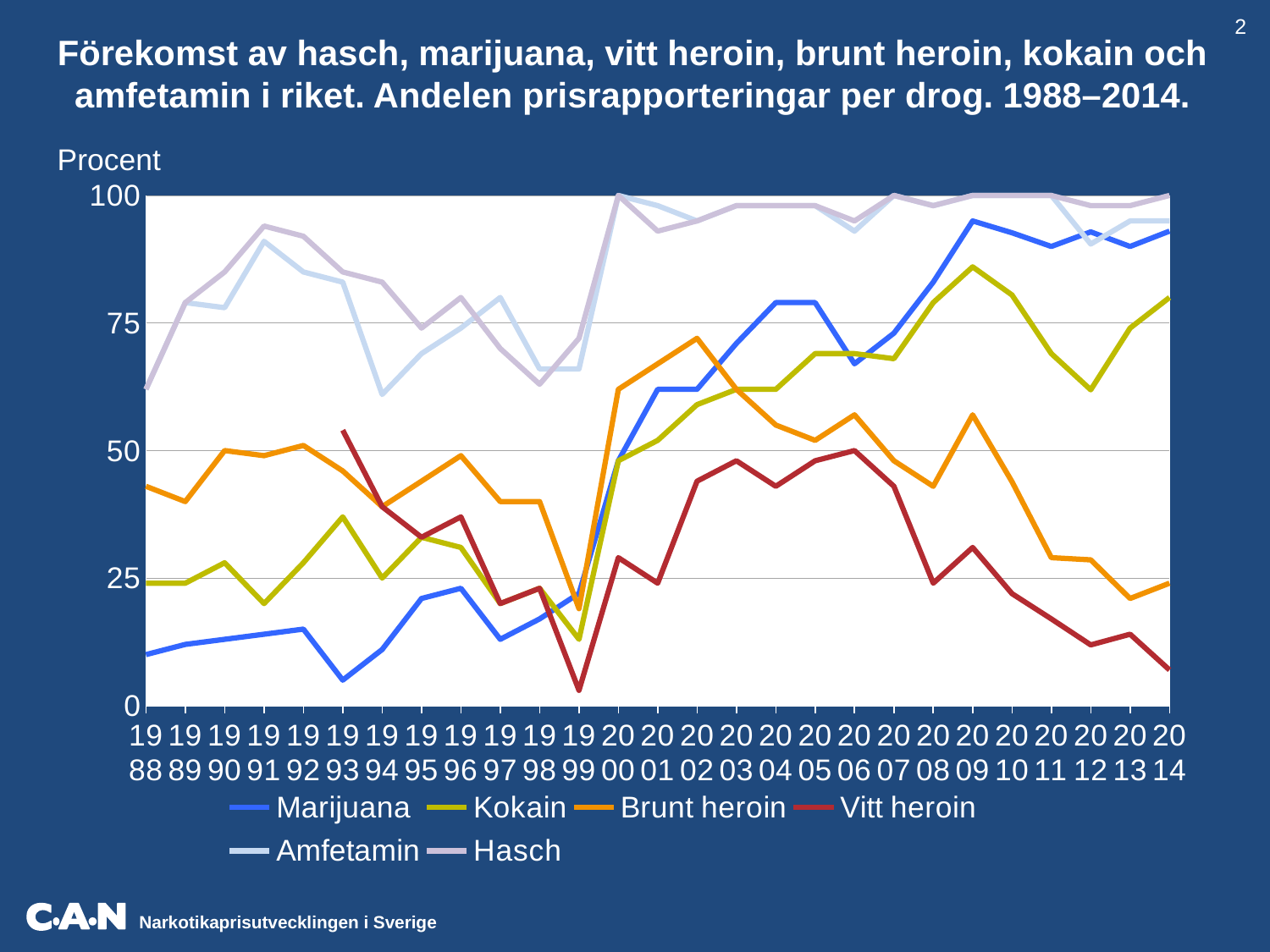
How many series does the legend list? 6 What kind of chart is shown on the slide? line chart Does the value for Vitt heroin rise or fall from 2007 to 2014? fall In 2014, which is larger: the value for Kokain or the value for Brunt heroin? Kokain Is the value for Kokain in 2009 greater or less than 75? greater Is the value for Brunt heroin in 2014 greater or less than 50? less How many years are plotted along the x axis? 27 Is the value for Hasch in 1988 greater or less than 50? greater Which series has the lowest value in 2014? Vitt heroin What is the label on the y axis? Procent Which series has the lowest value in 1988? Marijuana